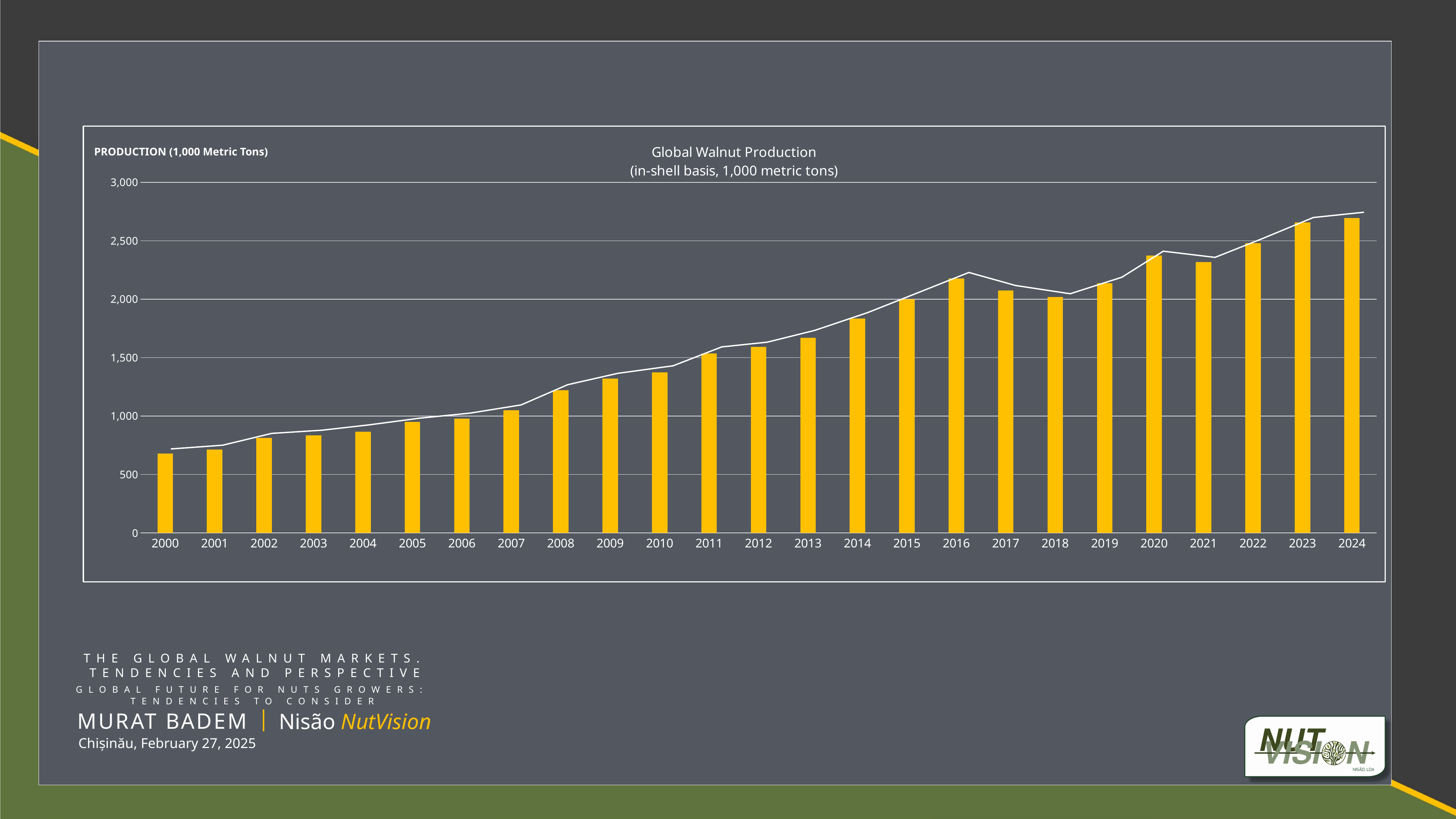
Which year has the highest walnut production bar? 2024 Is the production value for 2016 greater or less than 2,000? greater What is the title of the chart? Global Walnut Production (in-shell basis, 1,000 metric tons) Which year has the lowest walnut production bar? 2000 Do the production values generally rise or fall from 2000 to 2024? Rise Which year has the higher production bar, 2007 or 2008? 2008 Which year has the higher production bar, 2016 or 2017? 2016 How many years are plotted on the x axis of the chart? 25 Is the production value for 2024 greater or less than 2,500? greater What kind of chart is shown on the slide? Bar chart (with a line overlay) Is the production value for 2000 greater or less than 1,000? less